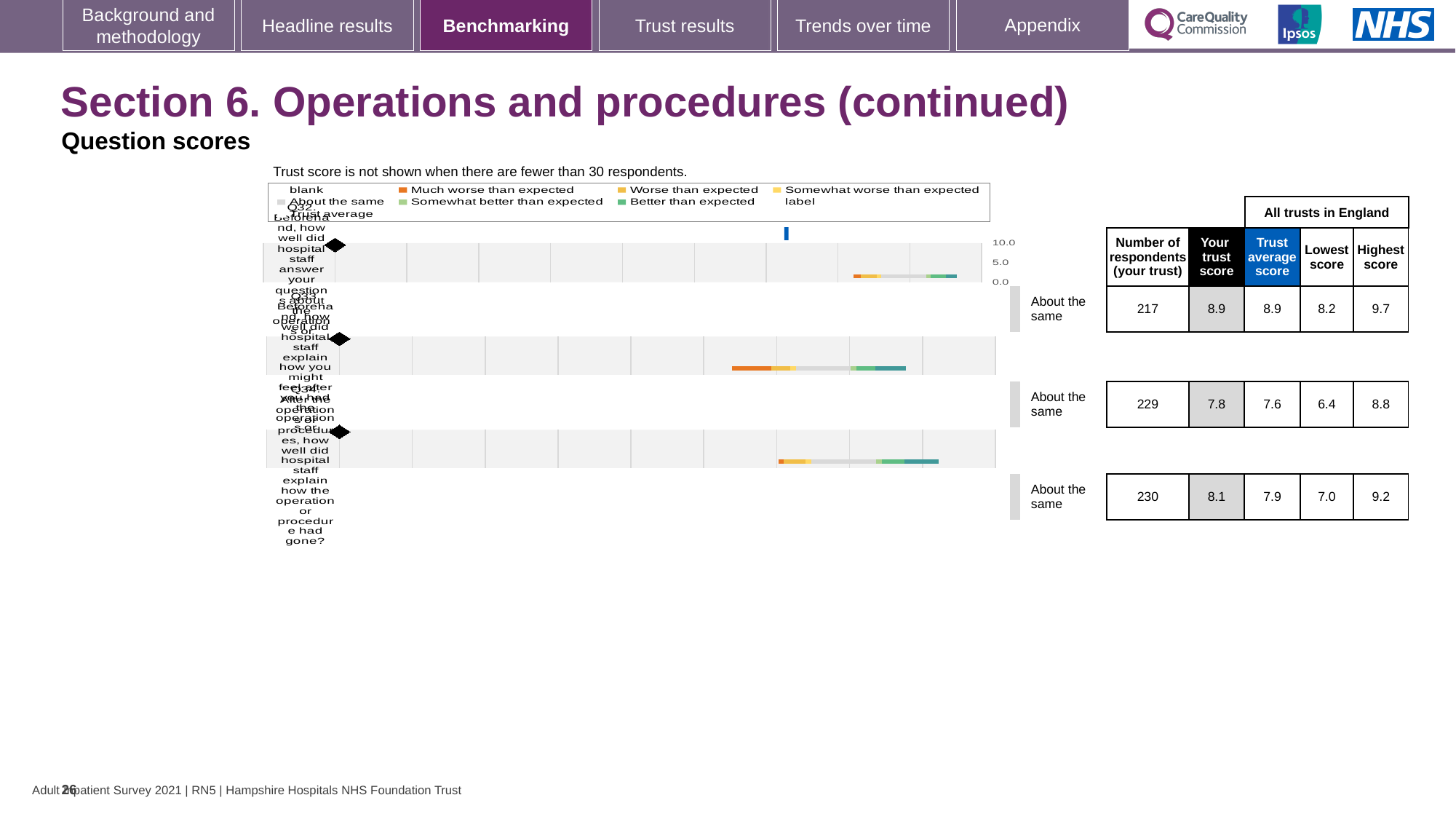
What is the 'Your trust score' value for the first question row (217 respondents)? 8.9 For the third question row, what is the difference between 'Your trust score' and 'Trust average score'? 0.2 Which question row has the lowest 'Your trust score'? The second row (7.8) For the second question row, what is the difference between the highest score and the lowest score? 2.4 How many respondents are shown for the second question row? 229 How many question rows are shown in the benchmarking chart? 3 What is the 'Trust average score' for the second question row (229 respondents)? 7.6 What benchmark category is shown for all three question rows? About the same Which question row has the highest 'Your trust score'? The first row (8.9) For the second question row, which is larger: 'Your trust score' or 'Trust average score'? Your trust score What is the 'Lowest score' for the first question row (217 respondents)? 8.2 What is the 'Highest score' for the third question row (230 respondents)? 9.2